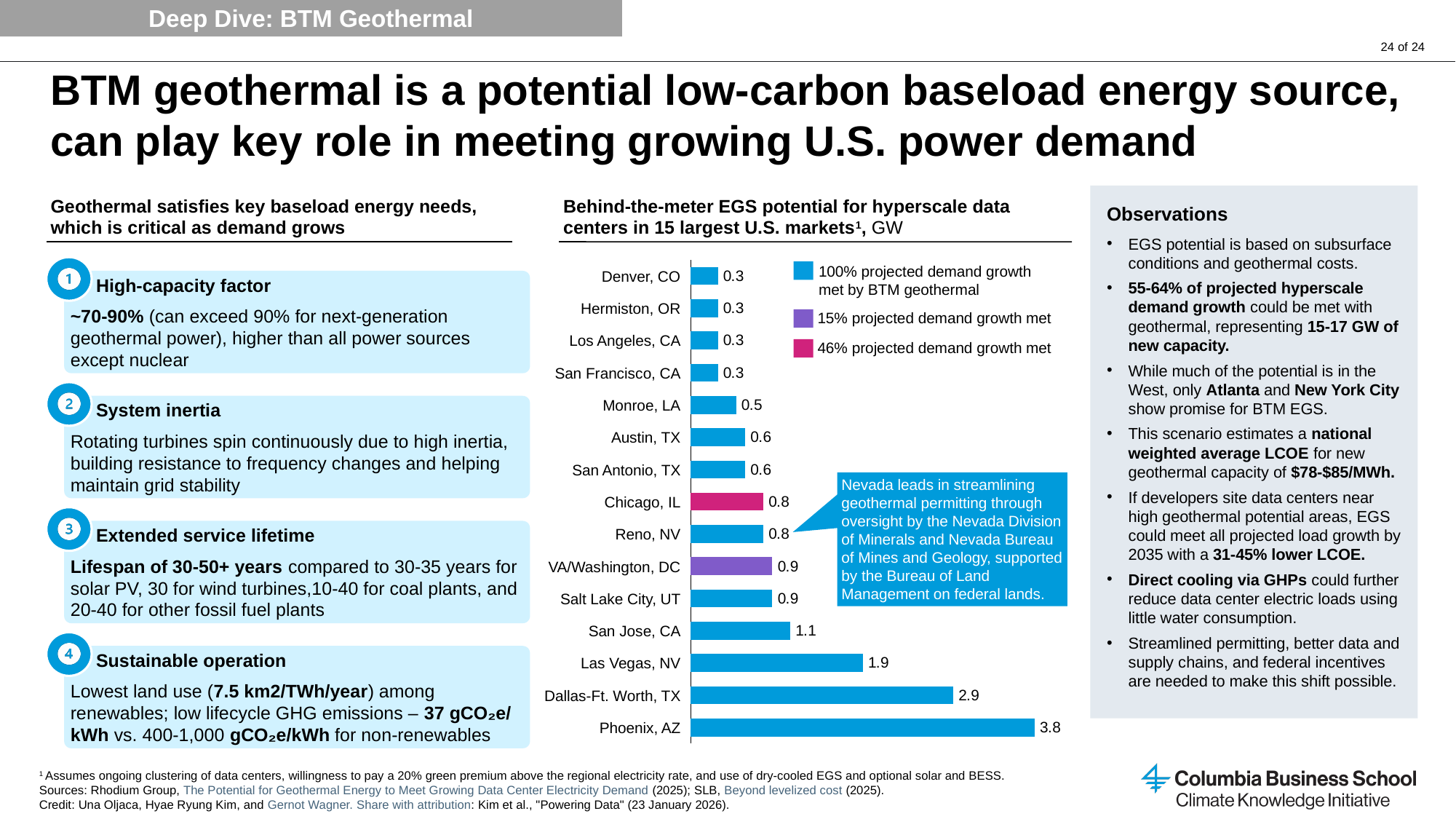
What type of chart is used to show BTM EGS potential by market? Bar chart Which has a larger BTM EGS potential, Monroe, LA or Salt Lake City, UT? Salt Lake City, UT What is the BTM EGS potential for Phoenix, AZ in GW? 3.8 What is the BTM EGS potential for Dallas-Ft. Worth, TX in GW? 2.9 What is the BTM EGS potential for Chicago, IL in GW? 0.8 How many markets are shown in the bar chart? 15 How many entries does the chart legend list? 3 Which market has the highest BTM EGS potential? Phoenix, AZ What is the difference in GW between Phoenix, AZ and Las Vegas, NV? 1.9 Which market's bar is shown in purple, indicating 15% of projected demand growth met? VA/Washington, DC Which has a larger BTM EGS potential, Las Vegas, NV or San Jose, CA? Las Vegas, NV What is the difference in GW between Dallas-Ft. Worth, TX and San Jose, CA? 1.8